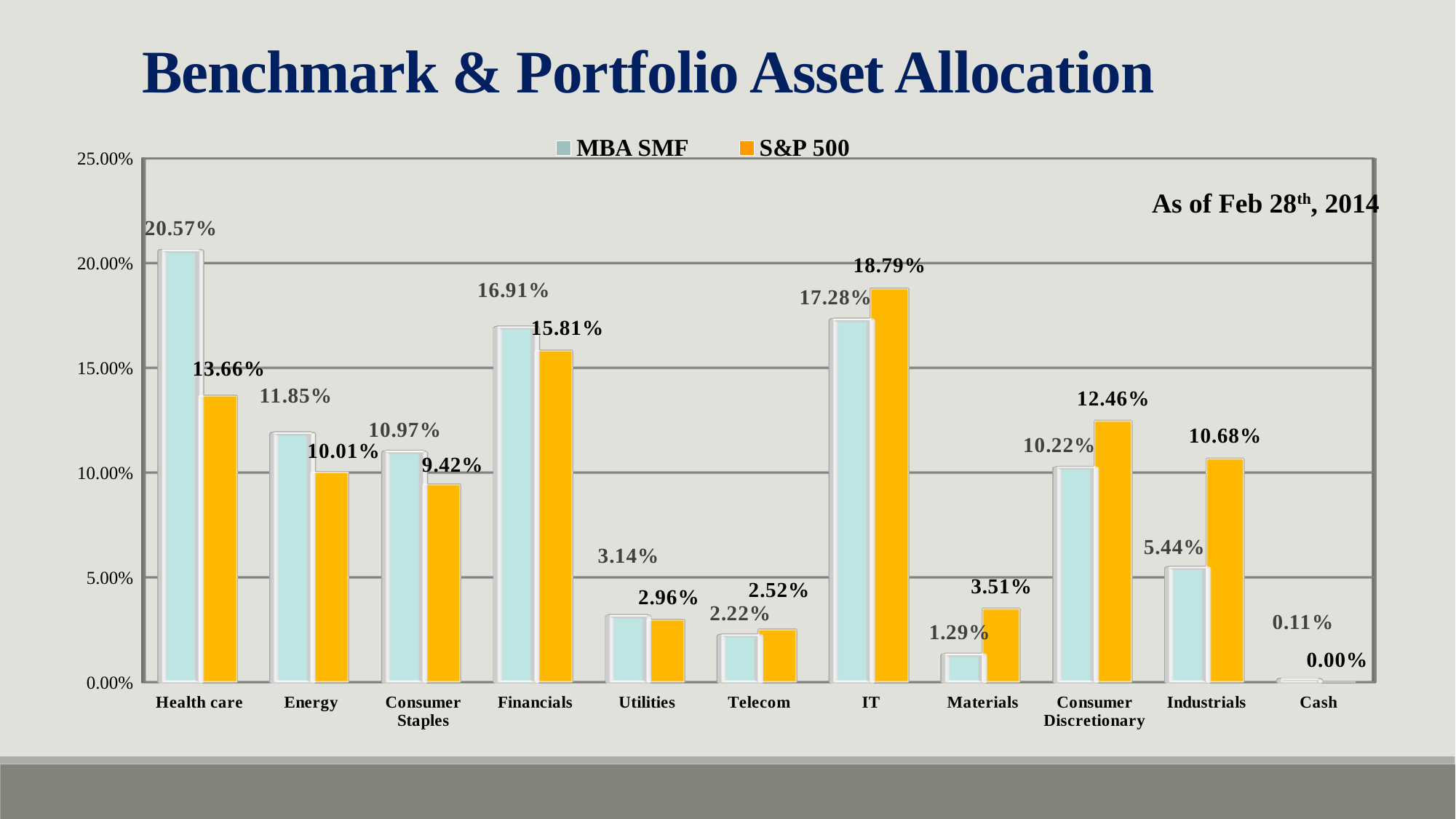
How many series does the legend list? 2 How many categories are shown on the x axis? 11 What is the S&P 500 value for IT? 18.79% What is the MBA SMF value for Materials? 1.29% Which category has the highest MBA SMF value? Health care For Financials, which series has the larger value, MBA SMF or S&P 500? MBA SMF Which category has the lowest MBA SMF value? Cash What is the MBA SMF value for Health care? 20.57% Which category has the highest S&P 500 value? IT What kind of chart is shown on the slide? Bar chart What is the S&P 500 value for Industrials? 10.68% What is the difference between the MBA SMF and S&P 500 values for Health care? 6.91%